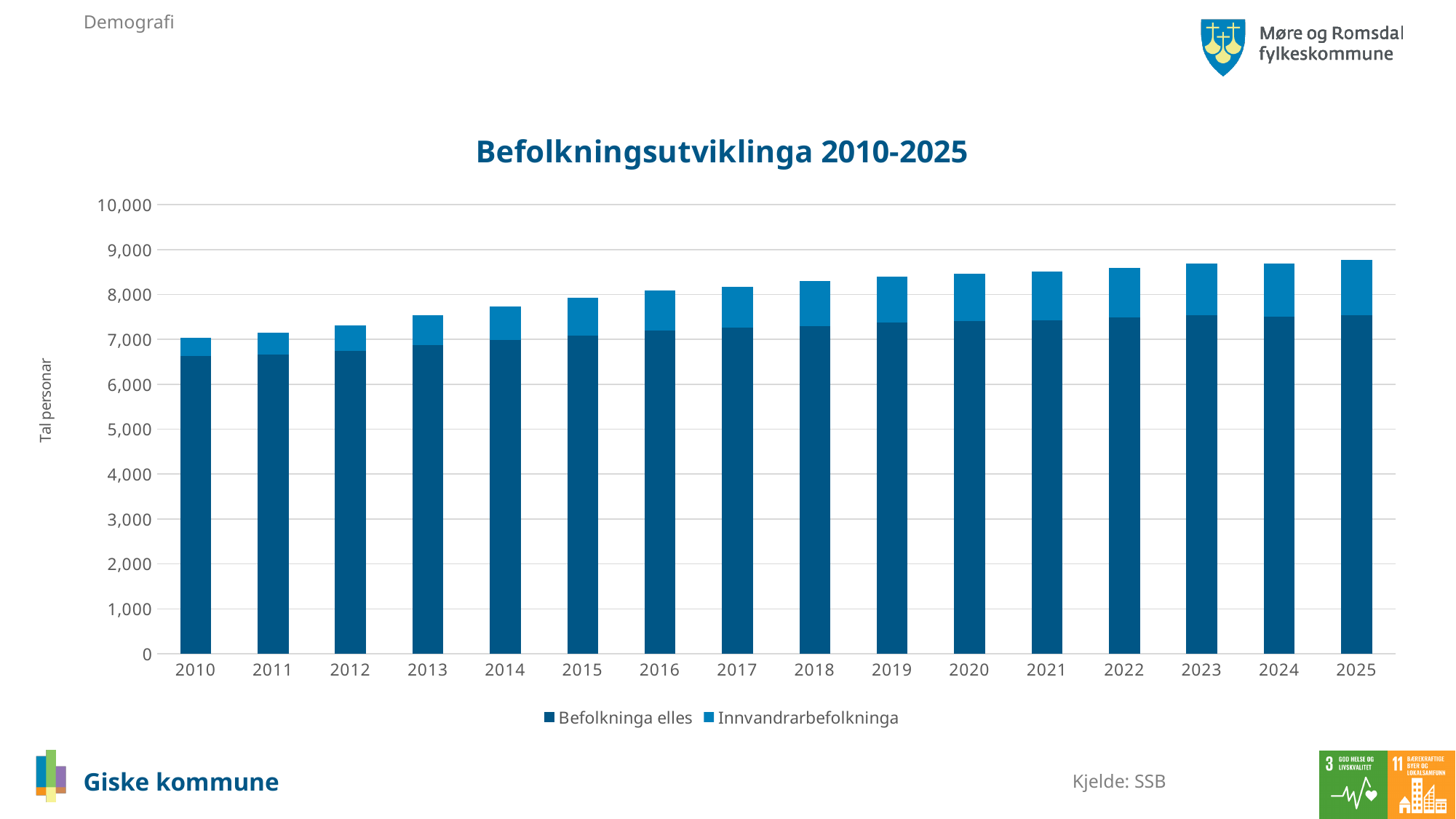
Is the value for Befolkninga elles in 2010 greater or less than 7,000? less What is the title of the chart? Befolkningsutviklinga 2010-2025 Is the value for Befolkninga elles in 2025 greater or less than 7,000? greater Do the total bar heights rise or fall from 2010 to 2025? Rise What kind of chart is shown on the slide? Stacked bar chart Is the total value for 2025 greater or less than 8,000? greater Which year has the tallest total bar? 2025 How many series does the legend list? 2 How many years are shown on the x axis? 16 What is the label on the y axis? Tal personar Which year has the shortest total bar? 2010